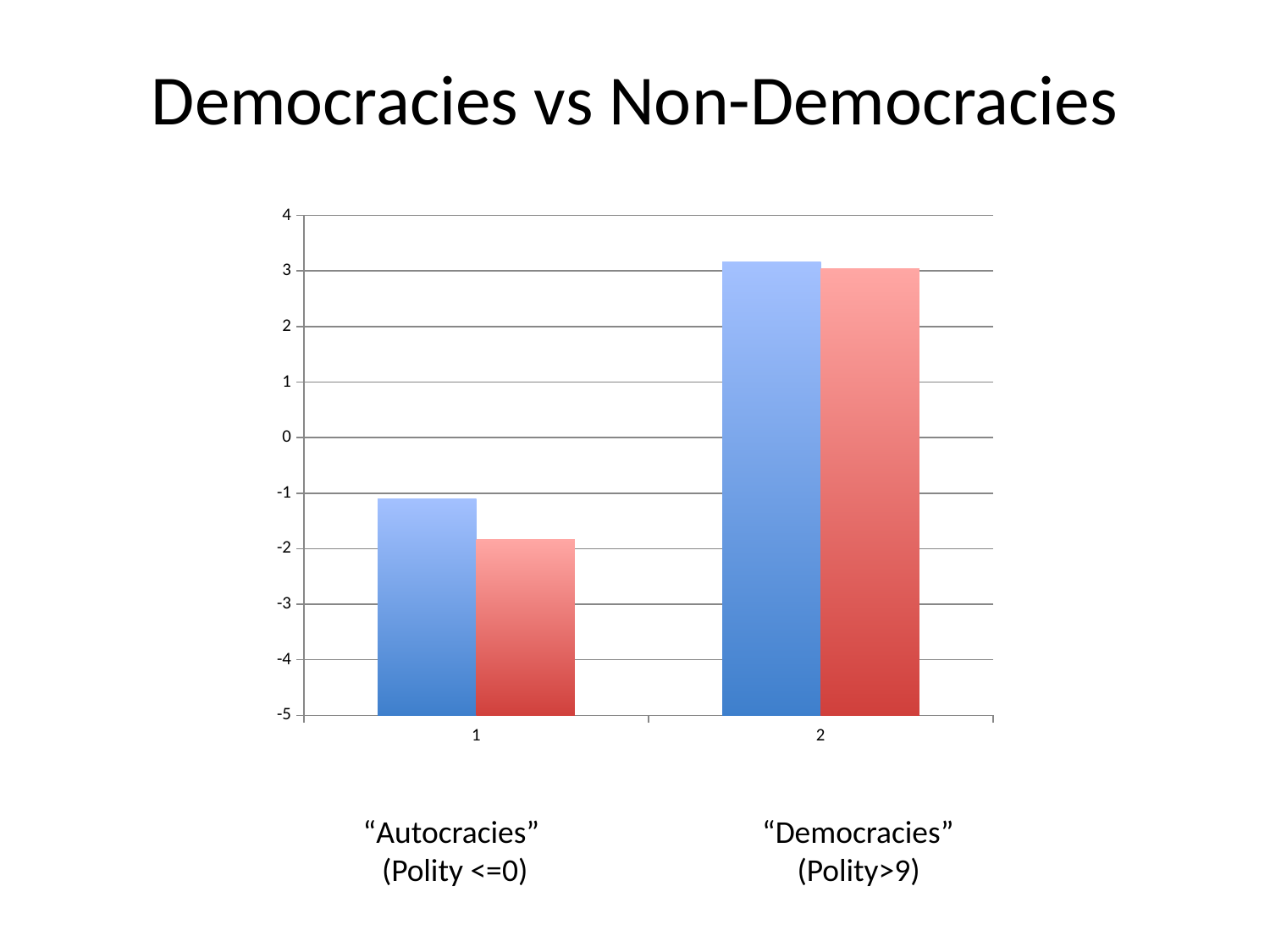
Is the value of the blue bar for "Autocracies" (Polity <=0) greater or less than 0? less What two colours are used for the bars in the chart? blue and red What is the title of the slide? Democracies vs Non-Democracies What kind of chart is shown on the slide? bar chart Which is larger, the blue bar for "Democracies" (Polity>9) or the blue bar for "Autocracies" (Polity <=0)? the blue bar for "Democracies" Is the value of the red bar for "Democracies" (Polity>9) greater or less than 2? greater Which bar in the chart has the lowest value? the red bar for "Autocracies" (Polity <=0) Do the values rise or fall from category 1 ("Autocracies") to category 2 ("Democracies")? rise How many categories are shown on the x axis of the chart? 2 Is the value of the blue bar for "Democracies" (Polity>9) greater or less than 2? greater For "Autocracies" (Polity <=0), which bar is higher, the blue bar or the red bar? the blue bar